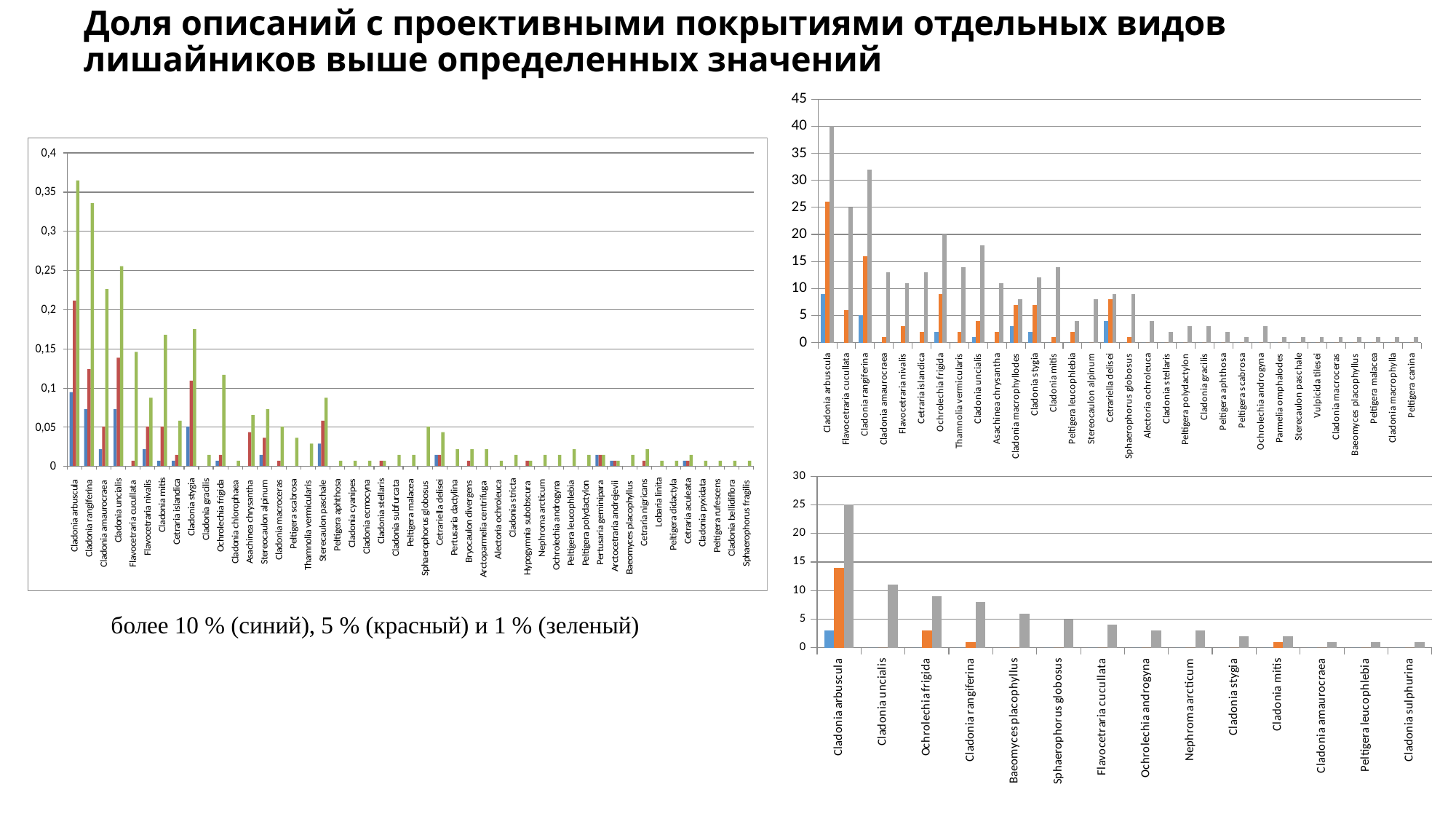
In the top-right chart, which gray bar is taller: Flavocetraria cucullata or Cladonia rangiferina? Cladonia rangiferina According to the caption under the left chart, which colour represents cover above 10%? синий (blue) In the top-right chart, which species has the tallest gray bar? Cladonia arbuscula In the bottom-right chart, which species has the tallest gray bar? Cladonia arbuscula In the bottom-right chart, is the gray bar for Cladonia uncialis greater or less than 10? greater In the left chart, which species has the tallest green bar? Cladonia arbuscula What kind of chart is the bottom-right chart? bar chart In the bottom-right chart, is the orange bar for Cladonia arbuscula greater or less than 10? greater In the bottom-right chart, how many species categories are shown on the x axis? 14 In the top-right chart, is the gray bar for Cladonia rangiferina greater or less than 30? greater In the bottom-right chart, do the gray bars generally rise or fall from left to right along the x axis? fall In the bottom-right chart, which gray bar is taller: Cladonia uncialis or Ochrolechia frigida? Cladonia uncialis